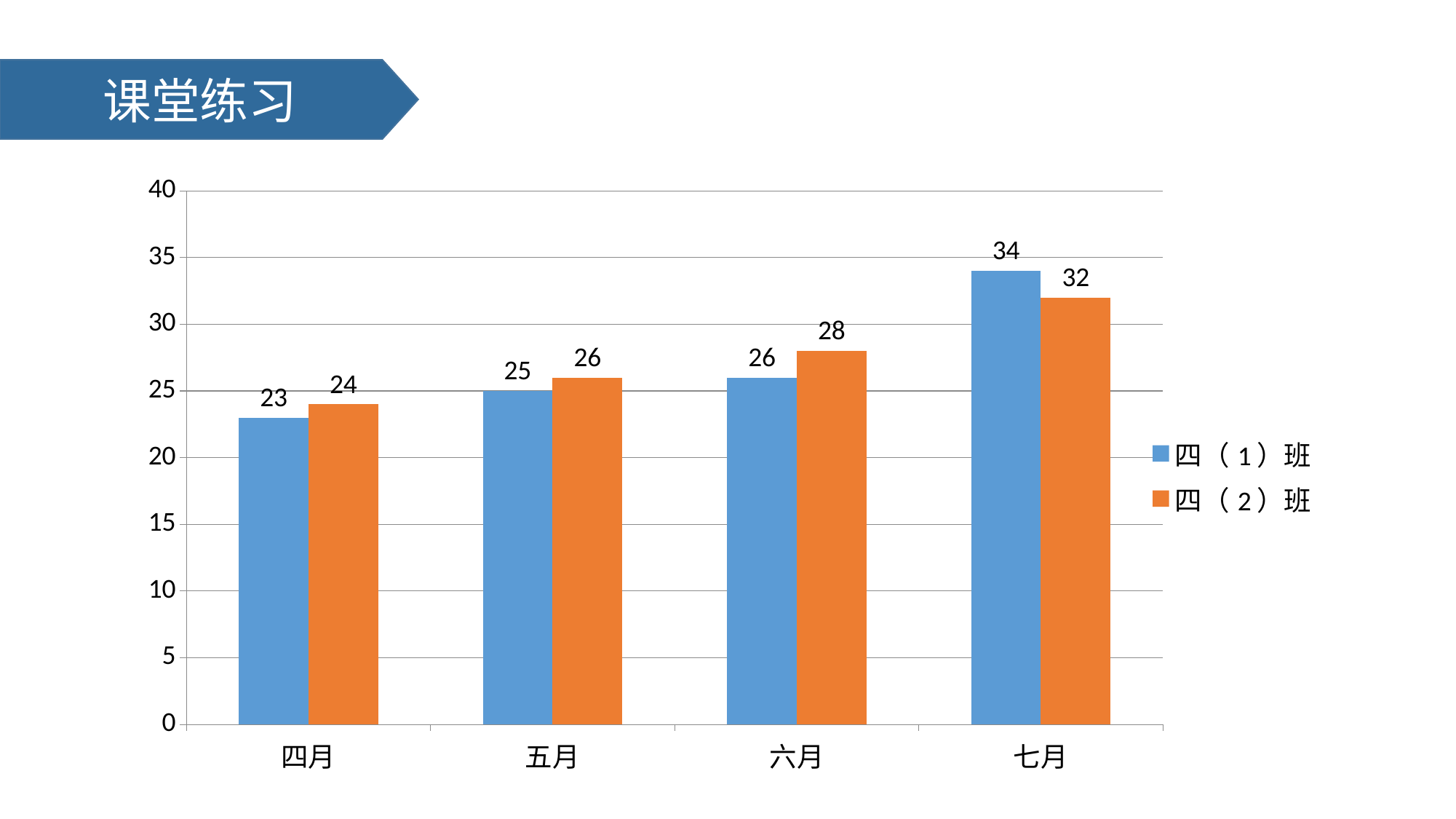
How many months are shown on the x axis? 4 How many series does the legend list? 2 What kind of chart is shown on the slide? bar chart What is the value for 四（2）班 in 六月? 28 What is the difference between 四（1）班 and 四（2）班 in 七月? 2 In which month is the value for 四（1）班 lowest? 四月 What is the difference between the 四（2）班 values for 七月 and 四月? 8 In which month is the value for 四（2）班 highest? 七月 Is the value for 四（1）班 in 六月 greater or less than 30? less What is the value for 四（1）班 in 七月? 34 What is the value for 四（1）班 in 四月? 23 Which is larger in 五月, 四（1）班 or 四（2）班? 四（2）班